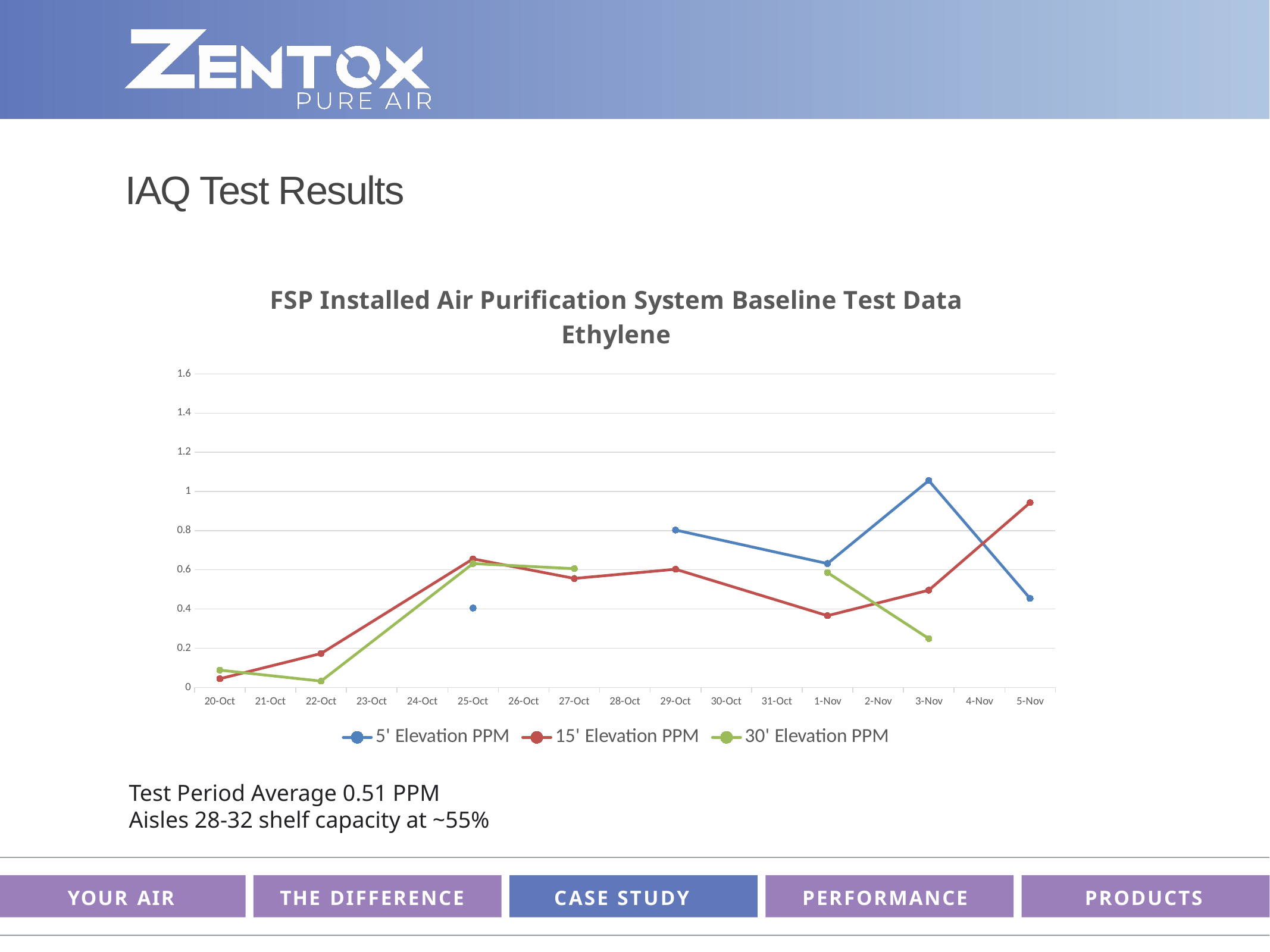
How many dates are labelled along the x axis? 17 Which series is plotted in green? 30' Elevation PPM Is the value for 5' Elevation PPM on 3-Nov greater or less than 1? greater On which date does the 5' Elevation PPM series reach its highest value? 3-Nov How many series does the legend list? 3 Is the value for 15' Elevation PPM on 20-Oct greater or less than 0.2? less On 5-Nov, which is larger: the 15' Elevation PPM value or the 5' Elevation PPM value? 15' Elevation PPM Is the value for 30' Elevation PPM on 3-Nov greater or less than 0.4? less What kind of chart is shown on the slide? Line chart On which date does the 15' Elevation PPM series reach its highest value? 5-Nov What is the second line of the chart title? Ethylene